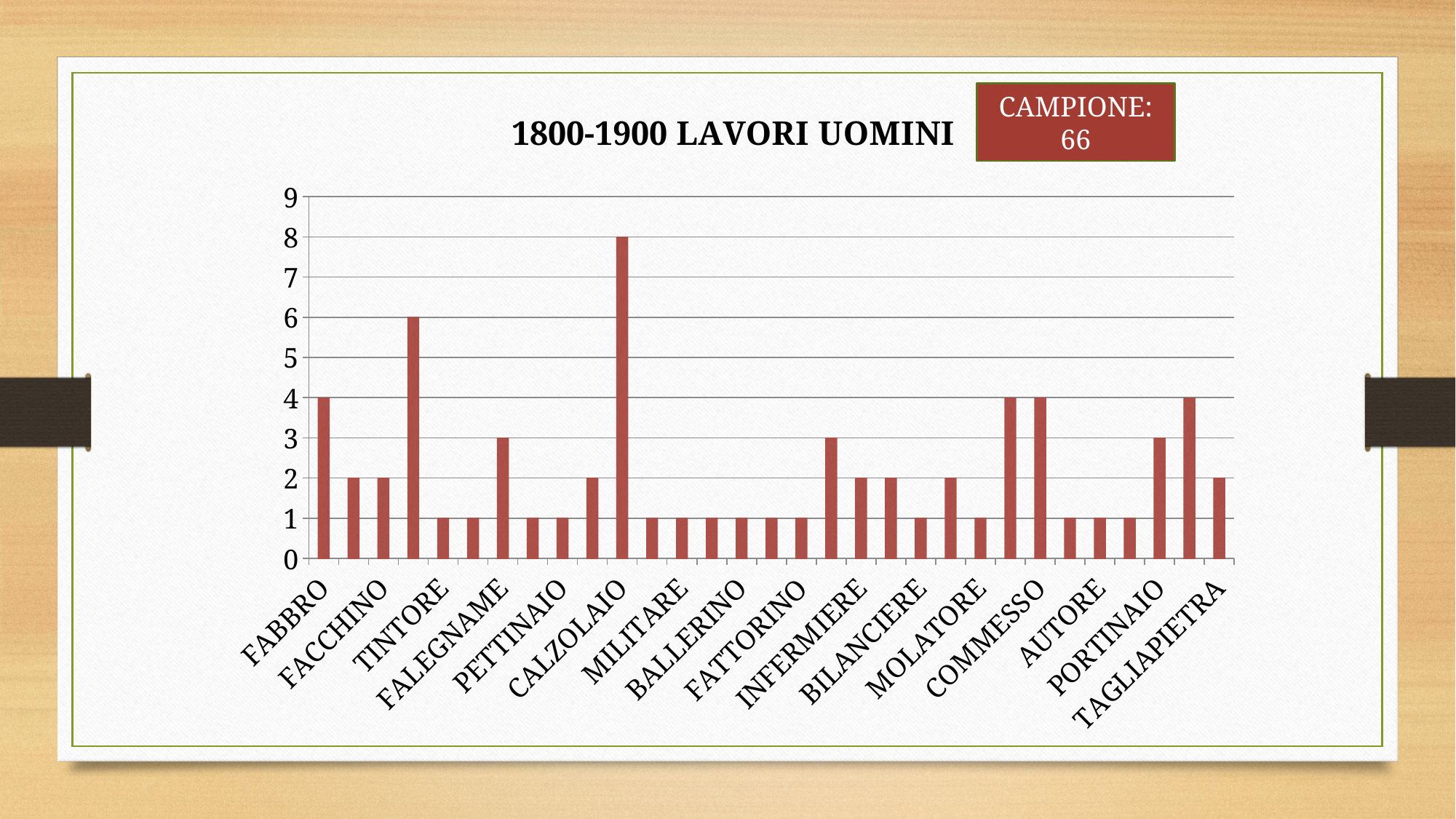
What is the value for CALZOLAIO? 8 What is the title of the chart? 1800-1900 LAVORI UOMINI What is the difference between the values for CALZOLAIO and FABBRO? 4 What sample size (CAMPIONE) is stated on the slide? 66 What is the value for TAGLIAPIETRA? 2 Which category has the highest bar in the chart? CALZOLAIO What type of chart is shown on the slide? bar chart Which is larger, the value for FABBRO or the value for FACCHINO? FABBRO What is the value for FALEGNAME? 3 Is the value for CALZOLAIO greater or less than 6? greater What is the value for COMMESSO? 4 What is the value for FABBRO? 4